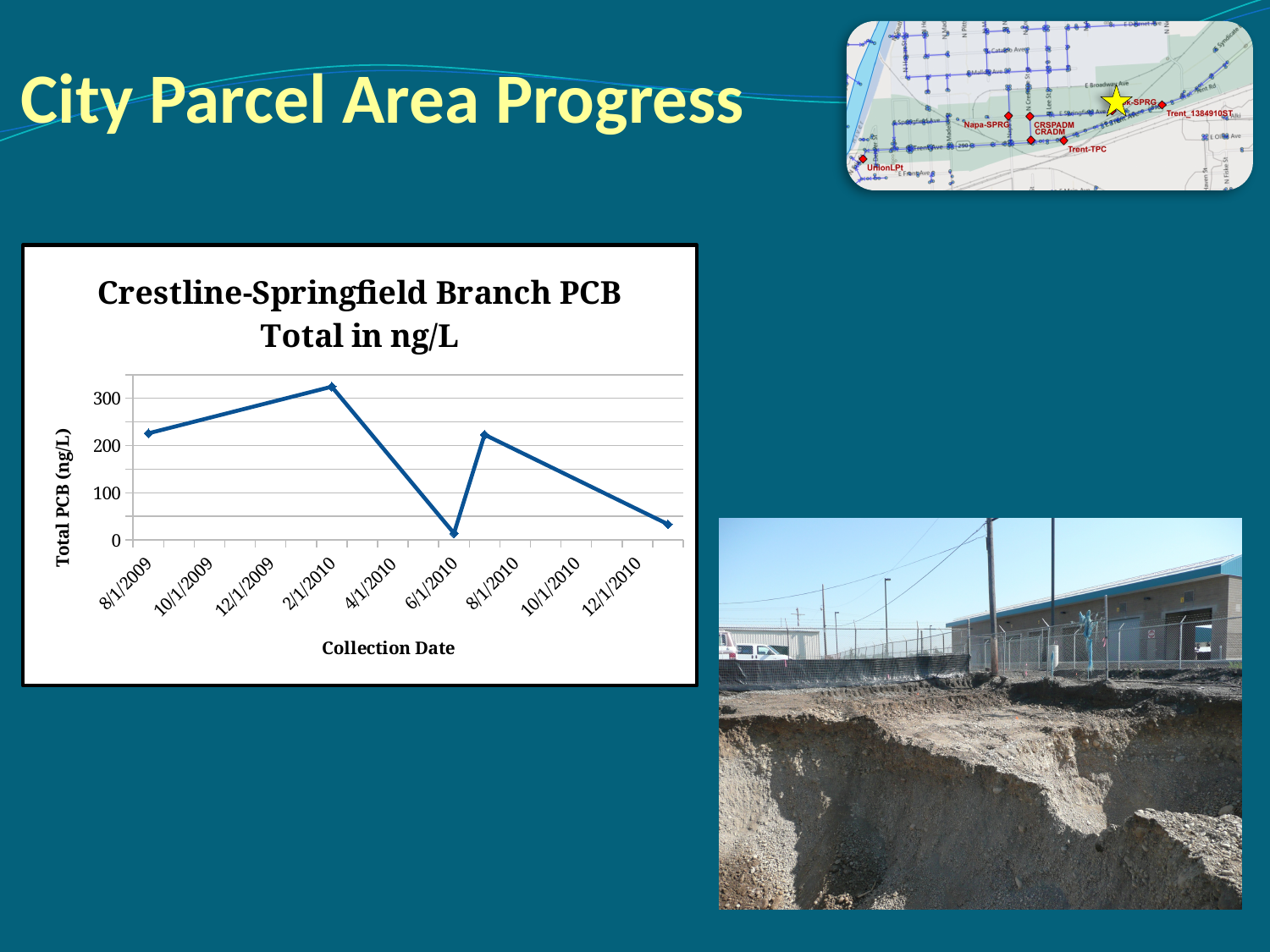
Which is larger, the value at the first point (8/1/2009) or the value at the last point (12/1/2010)? 8/1/2009 Around which collection date does the line reach its highest value? 2/1/2010 What is the title of the chart? Crestline-Springfield Branch PCB Total in ng/L Is the value at the first point (8/1/2009) greater or less than 200? greater What kind of chart is shown on the slide? line chart How many data points are plotted on the line? 5 Around which collection date does the line reach its lowest value? 6/1/2010 Is the value at the last point (12/1/2010) greater or less than 100? less Is the lowest value on the line greater or less than 50? less Overall, does the PCB total rise or fall from the first collection date to the last? fall What is the label of the x axis of the chart? Collection Date